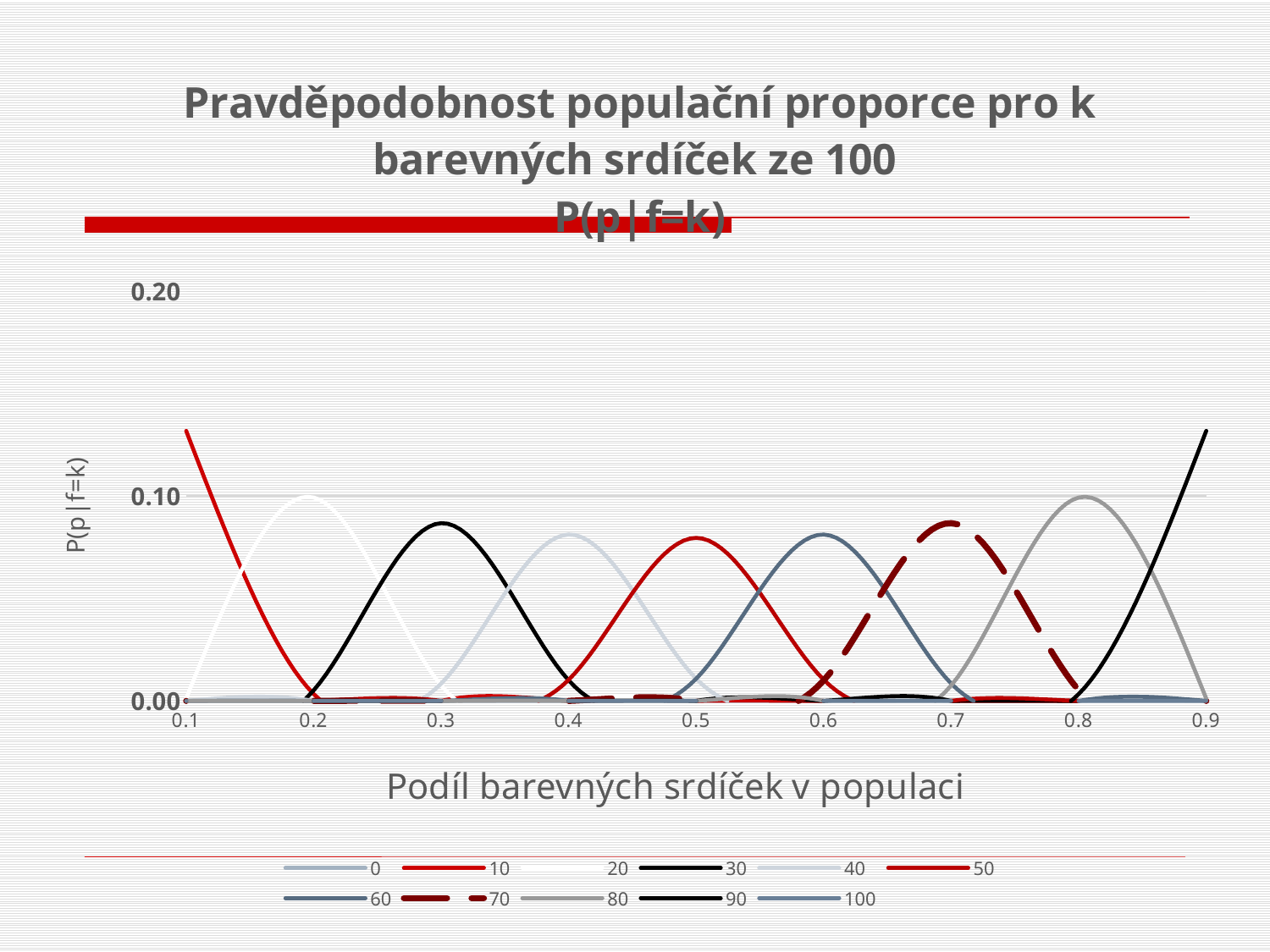
Which series has the highest value at x = 0.7? 70 Is the peak value of series 30 (at x = 0.3) greater or less than 0.10? less Is the value of series 90 at x = 0.9 greater or less than 0.10? greater Which series has the highest value at x = 0.5? 50 Is the value of series 10 at x = 0.1 greater or less than 0.10? greater Which is larger: the value of series 10 at x = 0.1 or the value of series 30 at x = 0.3? series 10 at x = 0.1 What is the title of the x axis? Podíl barevných srdíček v populaci Does series 10 rise or fall as x goes from 0.1 to 0.2? fall How many series does the legend list? 11 How many tick labels are shown on the x axis? 9 What kind of chart is shown on the slide? line chart